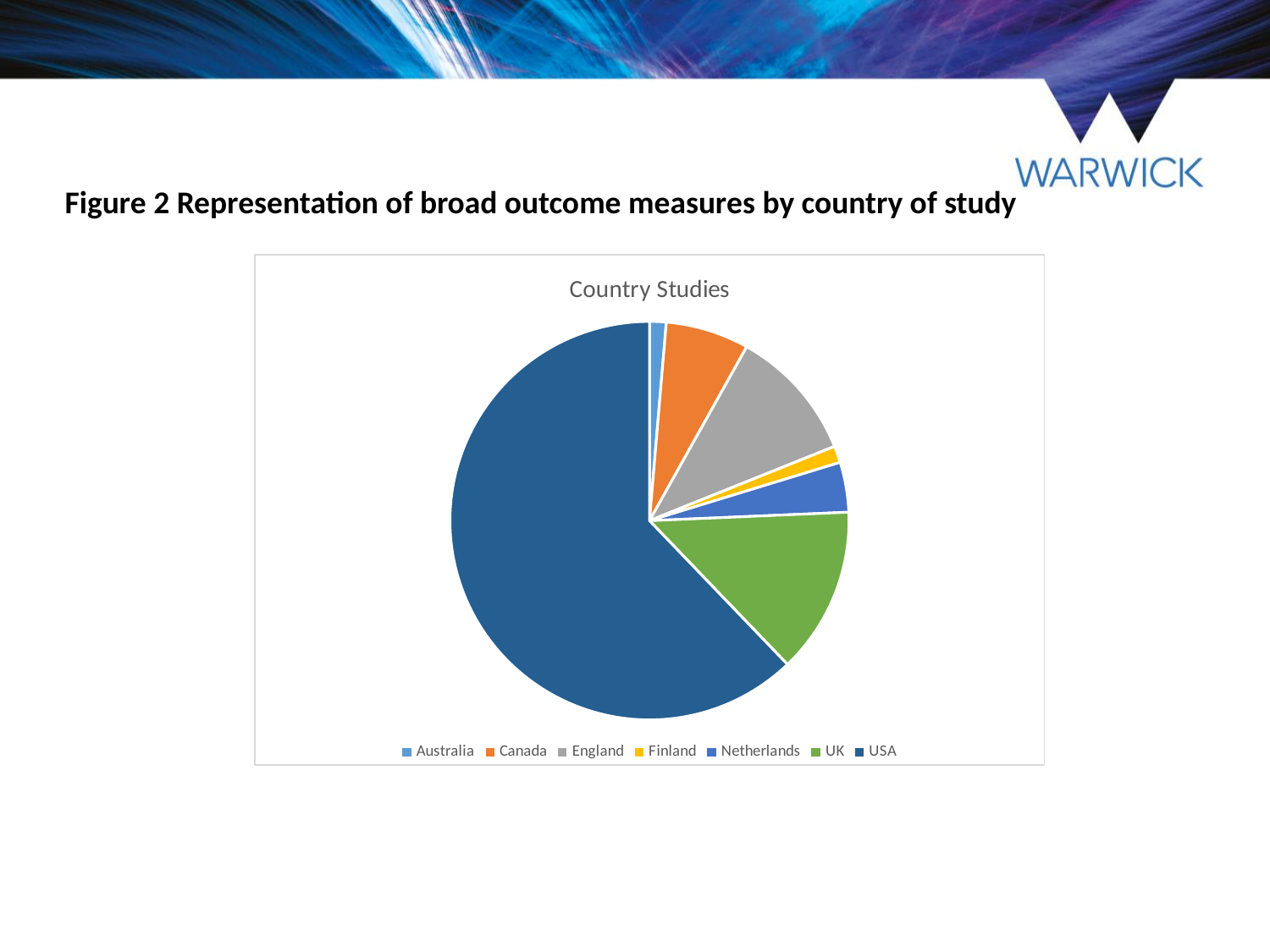
Which slice is larger in the Country Studies pie chart, UK or Canada? UK Which slice is larger in the Country Studies pie chart, Netherlands or Finland? Netherlands Which slice is larger in the Country Studies pie chart, USA or UK? USA How many countries are shown in the Country Studies pie chart? 7 Which country is shown in orange in the Country Studies pie chart? Canada What kind of chart is shown on the slide? pie chart Does the USA slice take up more or less than half of the Country Studies pie chart? more Which country has the largest slice in the Country Studies pie chart? USA What is the title of the pie chart? Country Studies